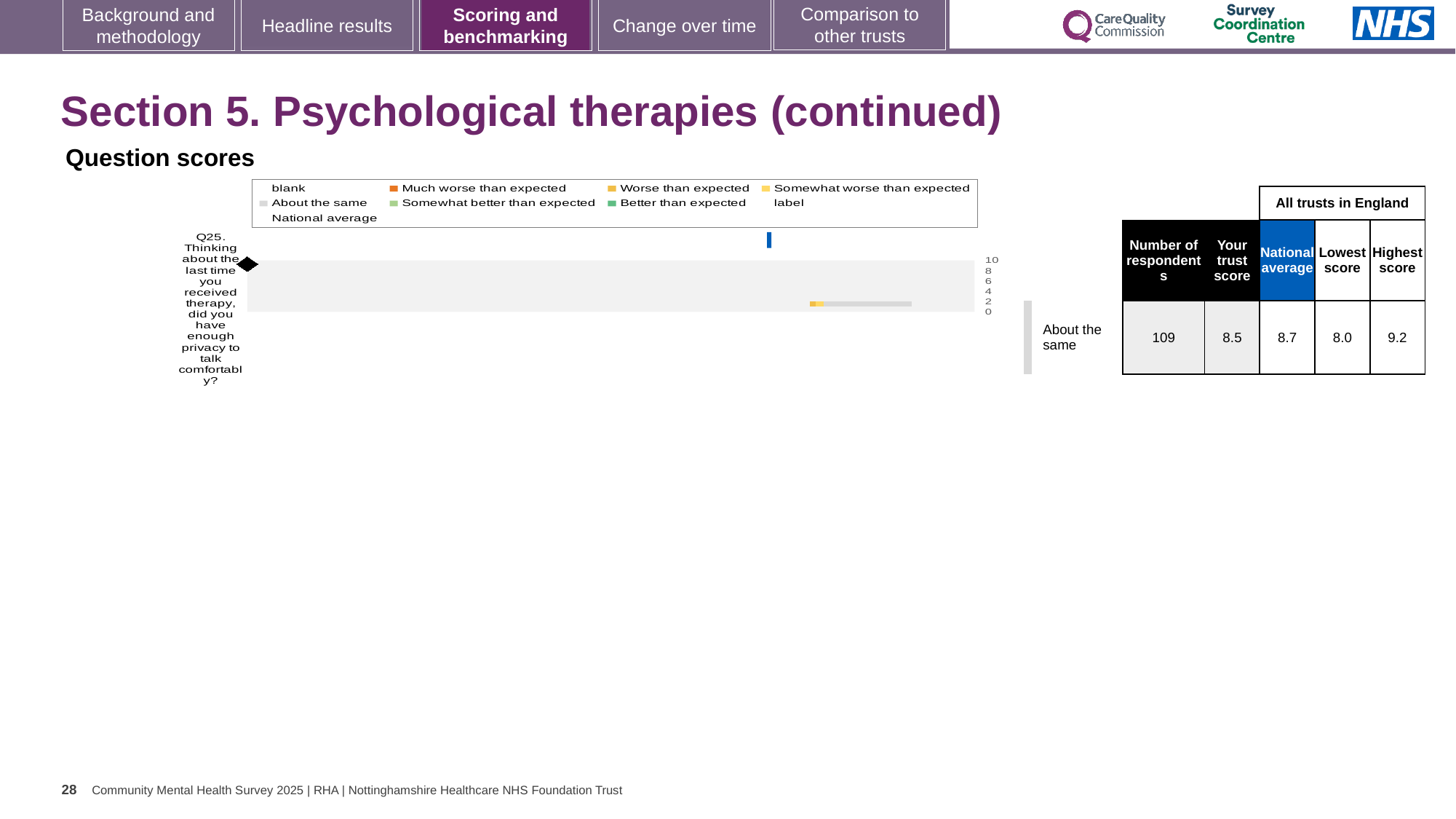
What is the difference between the highest score (9.2) and the lowest score (8.0) for Q25? 1.2 In the table beside the chart, what is the number of respondents for Q25? 109 In the table beside the chart, what is 'Your trust score' for Q25? 8.5 Which is larger for Q25: the trust score or the national average? national average What kind of chart is shown under 'Question scores'? bar chart In the table beside the chart, what is the highest score among all trusts in England for Q25? 9.2 What benchmark category is given for Q25 next to the chart? About the same In the table beside the chart, what is the lowest score among all trusts in England for Q25? 8.0 How many questions (categories) are plotted in the Question scores chart? 1 What is the highest value shown on the chart's numeric axis? 10 Which question number is plotted in the Question scores chart? Q25 In the table beside the chart, what is the national average for Q25? 8.7